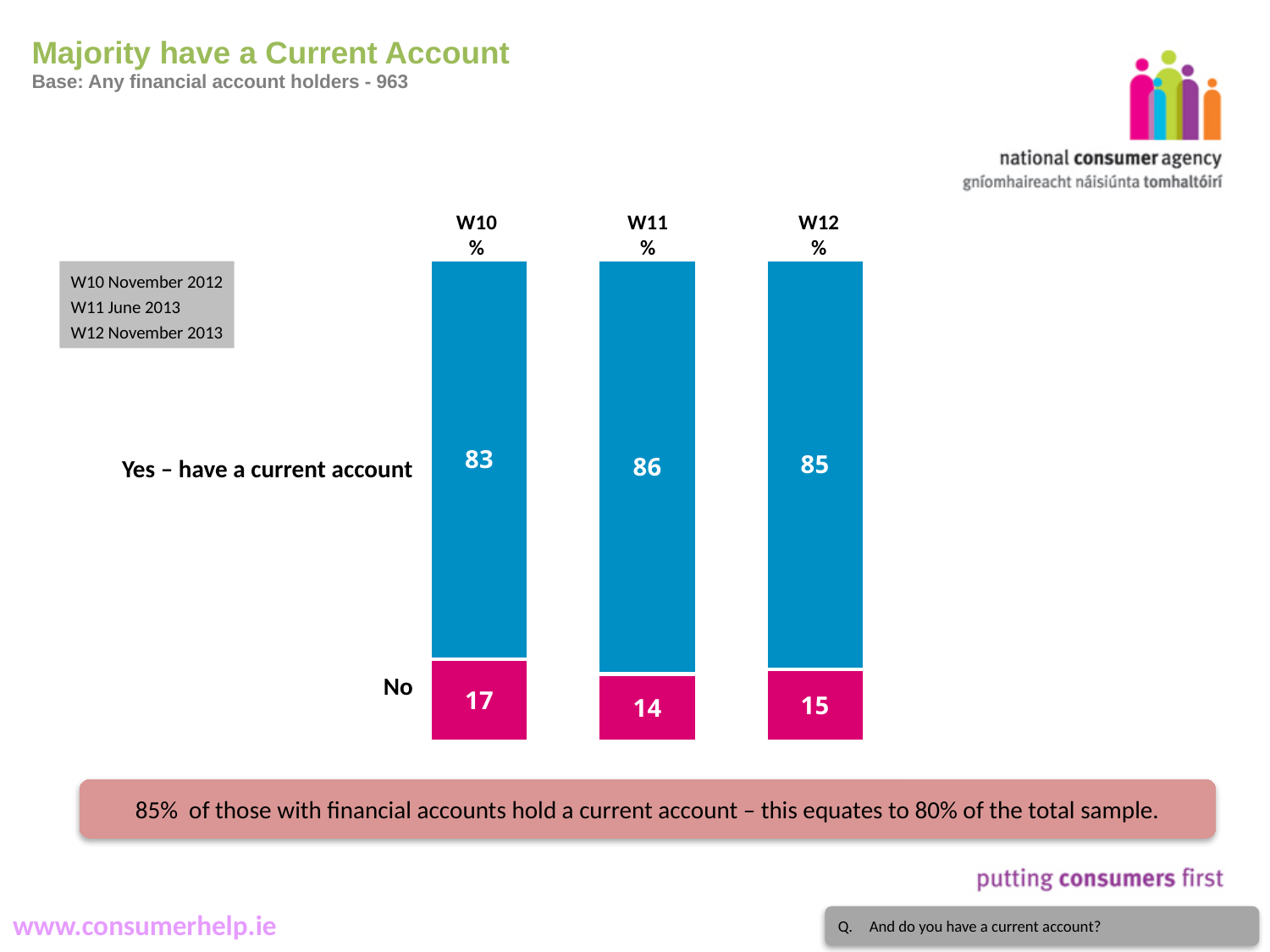
What is the difference between the 'Yes' values for W11 and W10? 3 What percentage of respondents in W10 have a current account? 83 What kind of chart is shown on the slide? Stacked bar chart What is the total of the W10 stacked bar (Yes plus No)? 100 How many waves (bars) are shown in the chart? 3 Which wave has the lowest 'No' value? W11 Is the 'No' value larger in W10 or in W12? W10 What is the 'Yes – have a current account' value for W12? 85 Which wave has the highest share of 'Yes – have a current account'? W11 What is the 'No' value for W11? 14 Which survey month and year does W11 correspond to? June 2013 What is the 'No' value for W12? 15